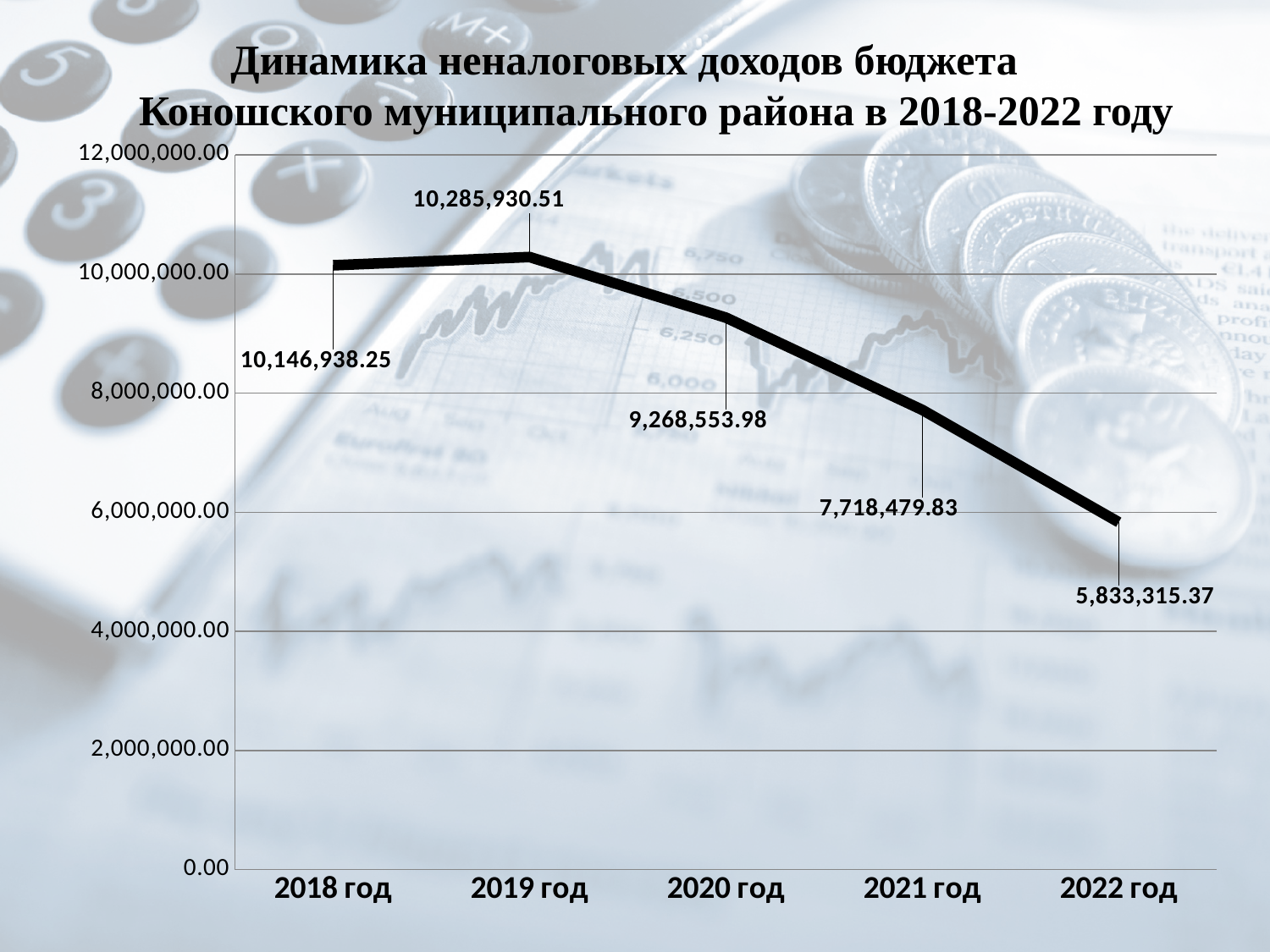
Which is larger, the value for 2018 год or 2019 год? 2019 год Which year has the highest value? 2019 год How many years are plotted on the chart? 5 What kind of chart is shown on the slide? line chart What is the value for 2018 год? 10,146,938.25 What is the value for 2019 год? 10,285,930.51 What is the value for 2020 год? 9,268,553.98 What is the difference between the values for 2020 год and 2021 год? 1,550,074.15 What is the difference between the values for 2021 год and 2022 год? 1,885,164.46 Is the value for 2021 год greater or less than 8,000,000.00? less Which year has the lowest value? 2022 год What is the value for 2022 год? 5,833,315.37